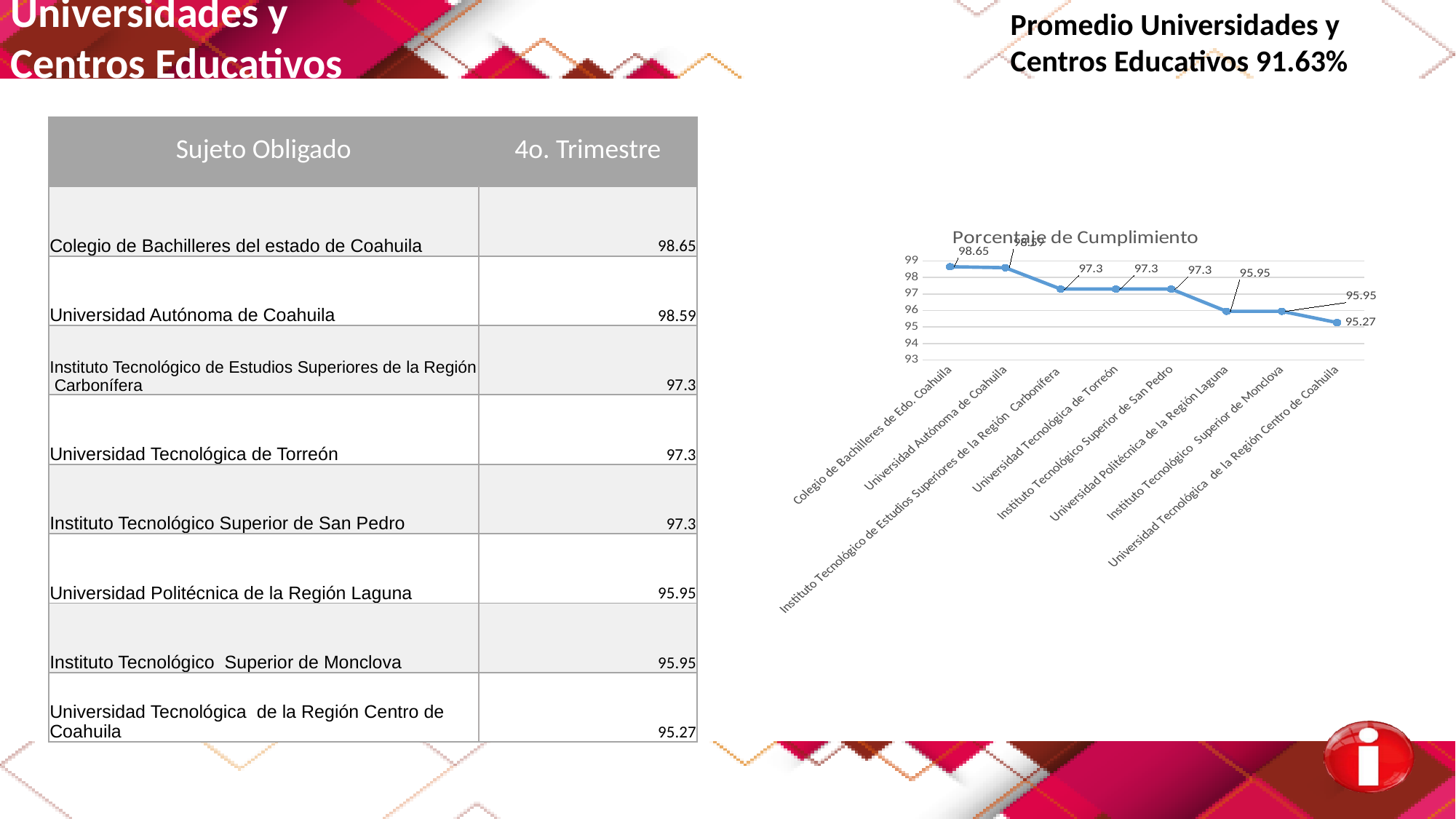
What is the value for Universidad Politécnica de la Región Laguna in the chart? 95.95 What type of chart is shown on the slide? line chart What is the value for Universidad Tecnológica de Torreón in the chart? 97.3 How many data points are plotted on the line chart? 8 Do the values in the chart generally rise or fall from left to right along the x axis? fall Which category has the highest value in the chart? Colegio de Bachilleres de Edo. Coahuila What is the difference between the values for Colegio de Bachilleres de Edo. Coahuila and Universidad Tecnológica de la Región Centro de Coahuila? 3.38 Which category has the lowest value in the chart? Universidad Tecnológica de la Región Centro de Coahuila What is the value for Colegio de Bachilleres de Edo. Coahuila in the chart? 98.65 Which is larger, the value for Instituto Tecnológico Superior de San Pedro or the value for Instituto Tecnológico Superior de Monclova? Instituto Tecnológico Superior de San Pedro What is the title of the chart? Porcentaje de Cumplimiento What is the value for Universidad Tecnológica de la Región Centro de Coahuila in the chart? 95.27